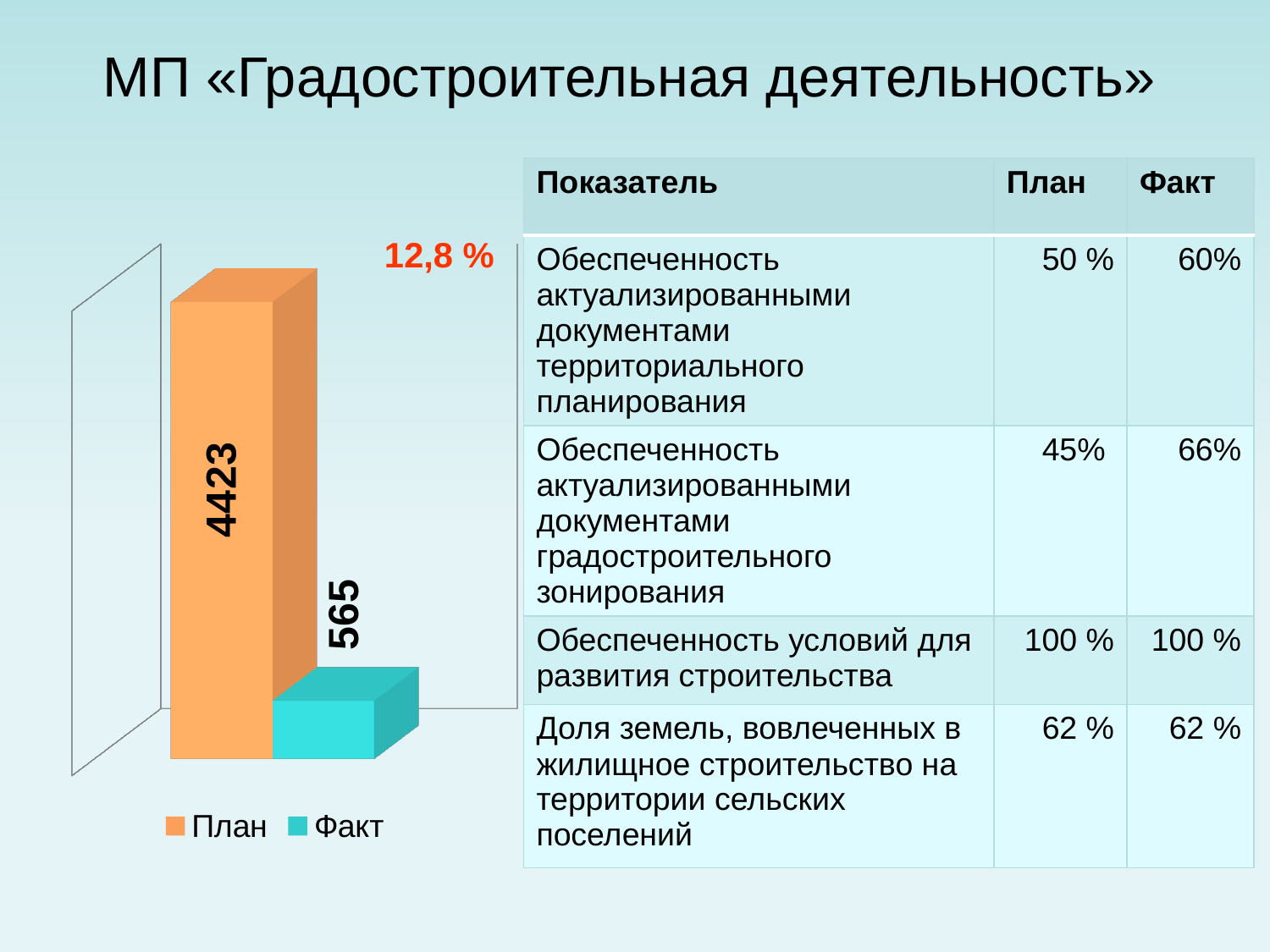
What colour is the Факт bar in the chart? Turquoise (cyan) What is the difference between the План and Факт values in the chart? 3858 Which bar in the chart is the lowest? Факт How many series does the chart legend list? 2 Which series has the higher bar in the chart, План or Факт? План What percentage is printed in red above the chart? 12,8 % How many bars are plotted in the chart? 2 What kind of chart is shown on the slide? Bar chart What is the value of the Факт bar in the chart? 565 Which bar in the chart is the highest? План What is the value of the План bar in the chart? 4423